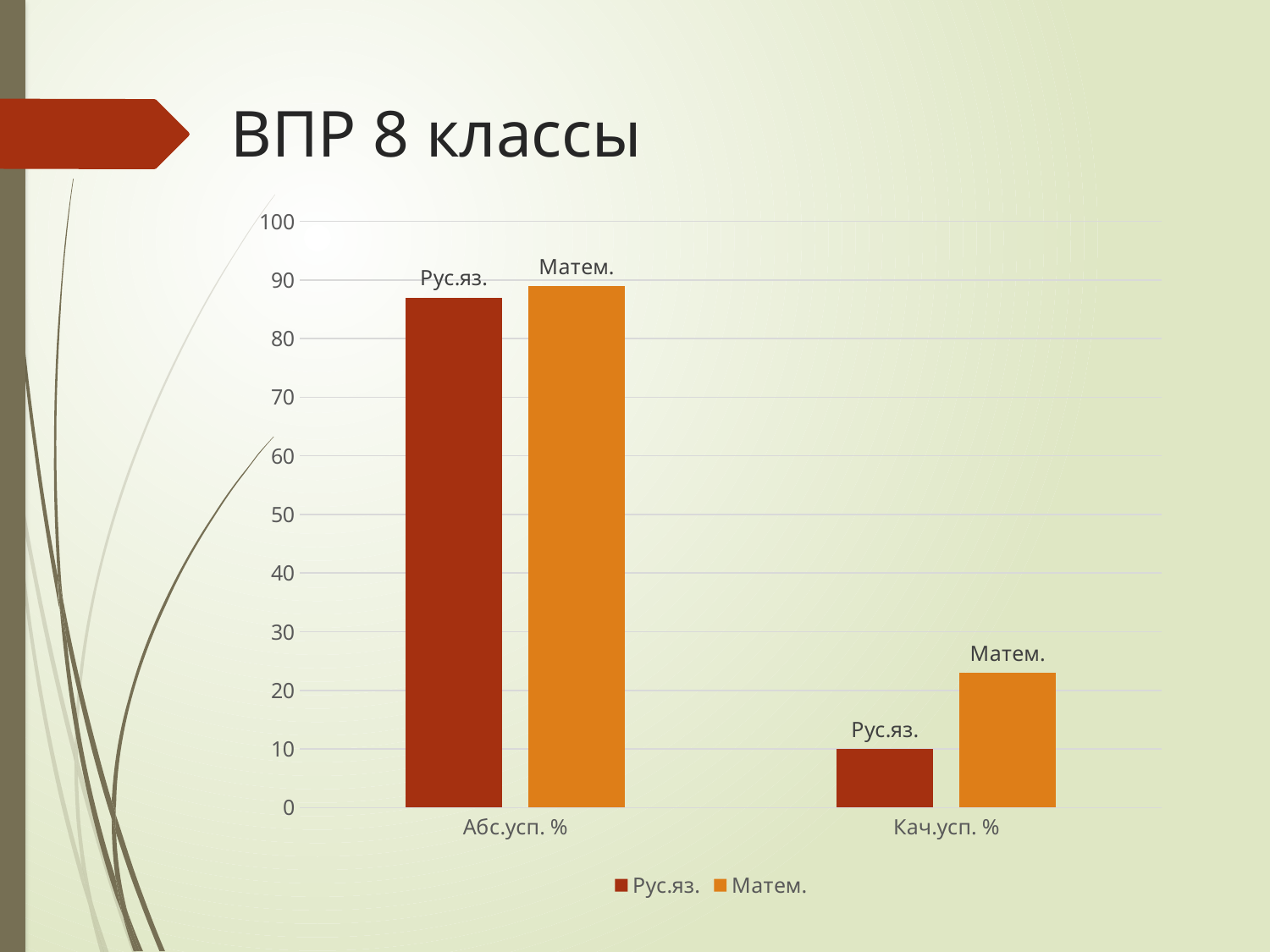
How many series does the legend list? 2 Is the value for Рус.яз. in Абс.усп. % greater or less than 80? greater Is the value for Матем. in Кач.усп. % greater or less than 30? less Is the value for Матем. in Абс.усп. % greater or less than 80? greater What is the title of the slide with the chart? ВПР 8 классы Which series are listed in the legend? Рус.яз. and Матем. In the Кач.усп. % category, which series has the larger value, Рус.яз. or Матем.? Матем. Which bar is the lowest in the chart? Рус.яз. in Кач.усп. % What kind of chart is shown on the slide? bar chart How many categories are shown on the x axis? 2